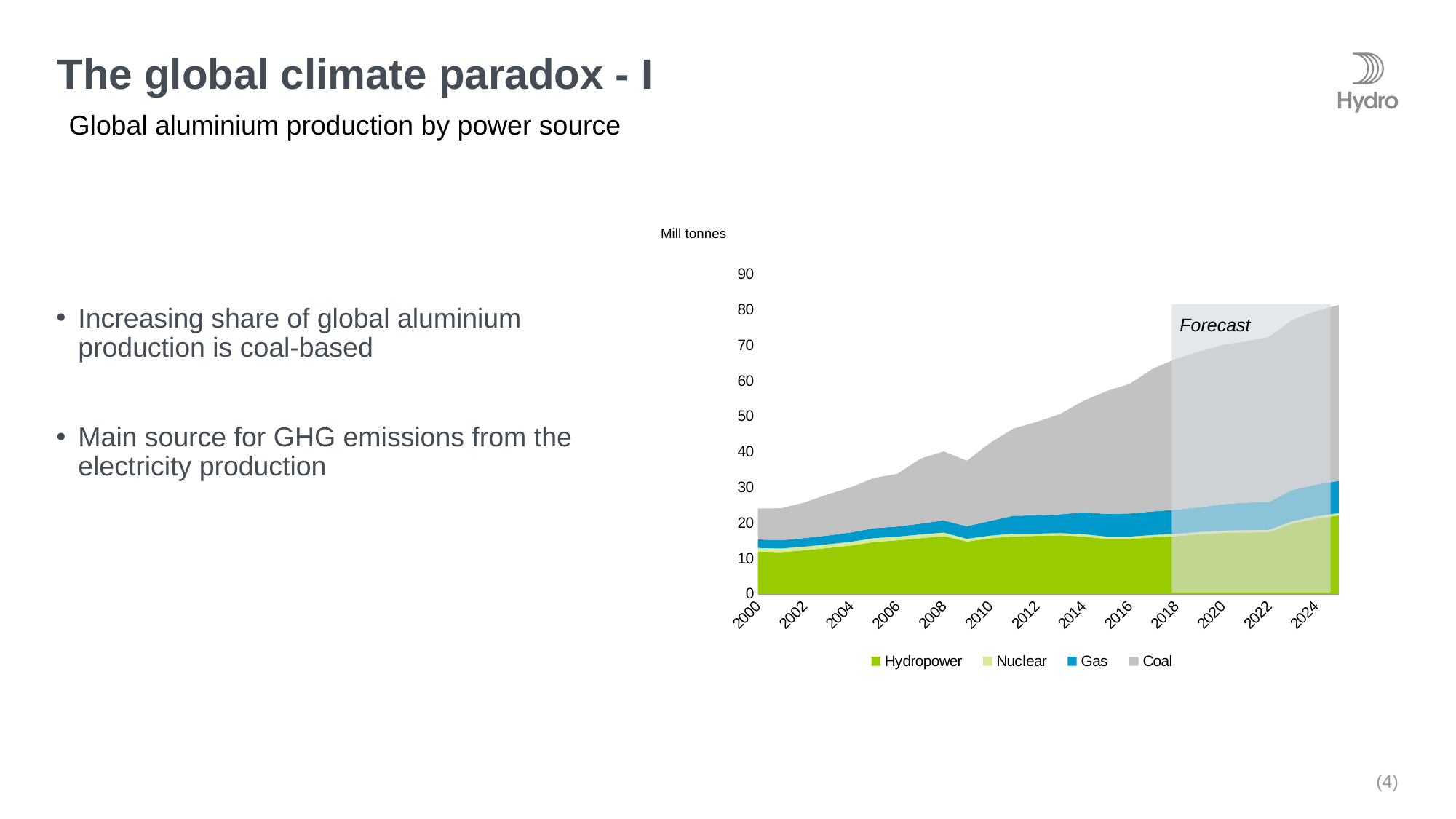
Is the total production in 2000 greater or less than 30 mill tonnes? less How many series does the legend list? 4 Is the total production in 2010 greater or less than 50 mill tonnes? less Does total global aluminium production rise or fall from 2000 to 2024 in the chart? Rise Which power sources are listed in the chart legend? Hydropower, Nuclear, Gas, Coal Which power source accounts for the smallest share of production in 2024? Nuclear What unit is shown on the y axis of the chart? Mill tonnes How many year labels are shown on the x axis? 13 Is the hydropower-based production in 2000 greater or less than 20 mill tonnes? less Which power source accounts for the largest share of production in 2024? Coal What kind of chart is shown on the slide? Stacked area chart